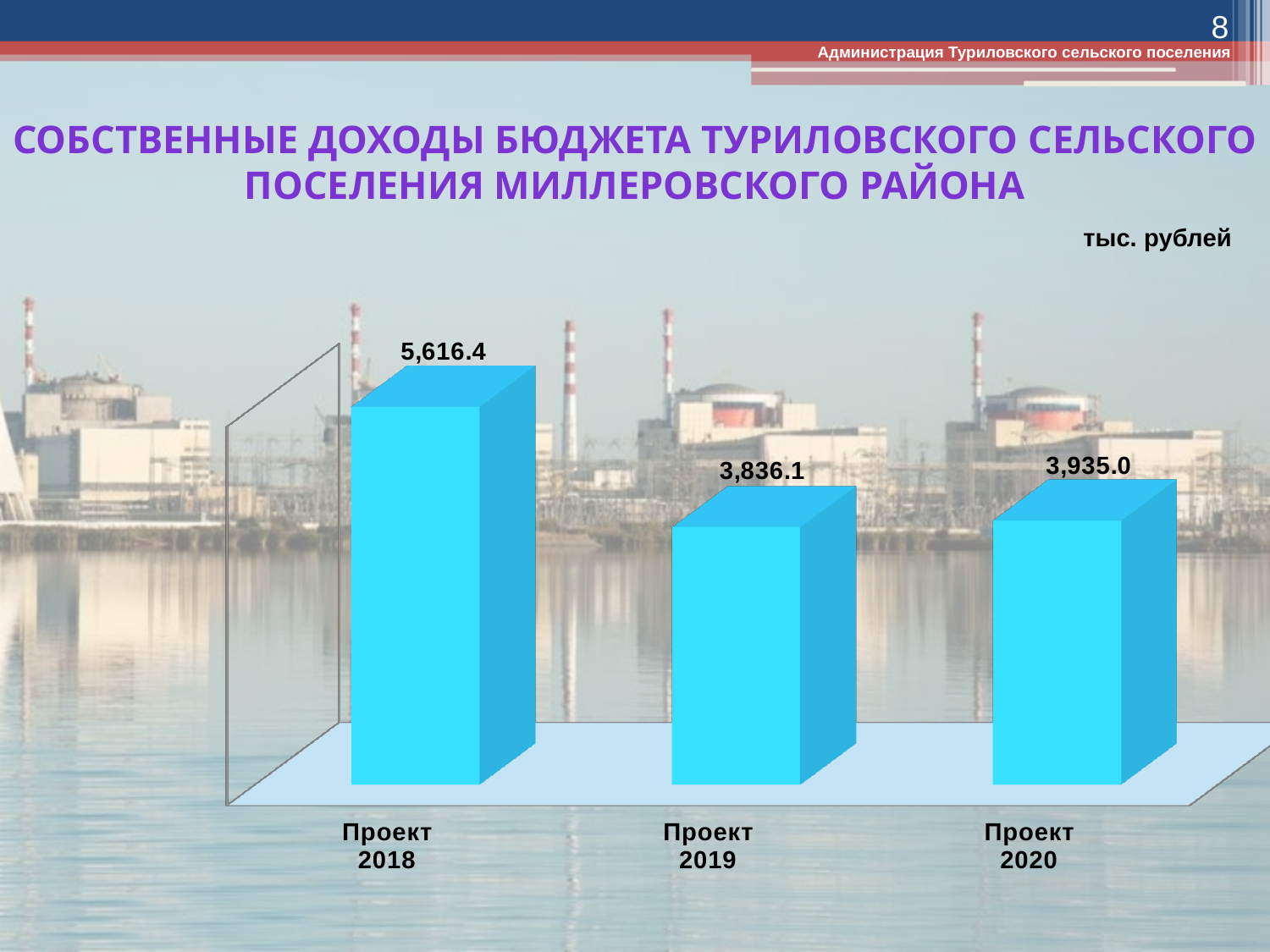
What is the value for Проект 2019? 3,836.1 What unit of measurement is indicated for the chart values? тыс. рублей What is the value for Проект 2018? 5,616.4 Which is larger, the value for Проект 2018 or Проект 2020? Проект 2018 Does the value fall or rise from Проект 2018 to Проект 2019? fall Which category has the highest value? Проект 2018 What is the value for Проект 2020? 3,935.0 Which category has the lowest value? Проект 2019 What is the difference between the values for Проект 2018 and Проект 2019? 1,780.3 How many categories are shown in the chart? 3 What is the difference between the values for Проект 2020 and Проект 2019? 98.9 What kind of chart is shown on the slide? bar chart